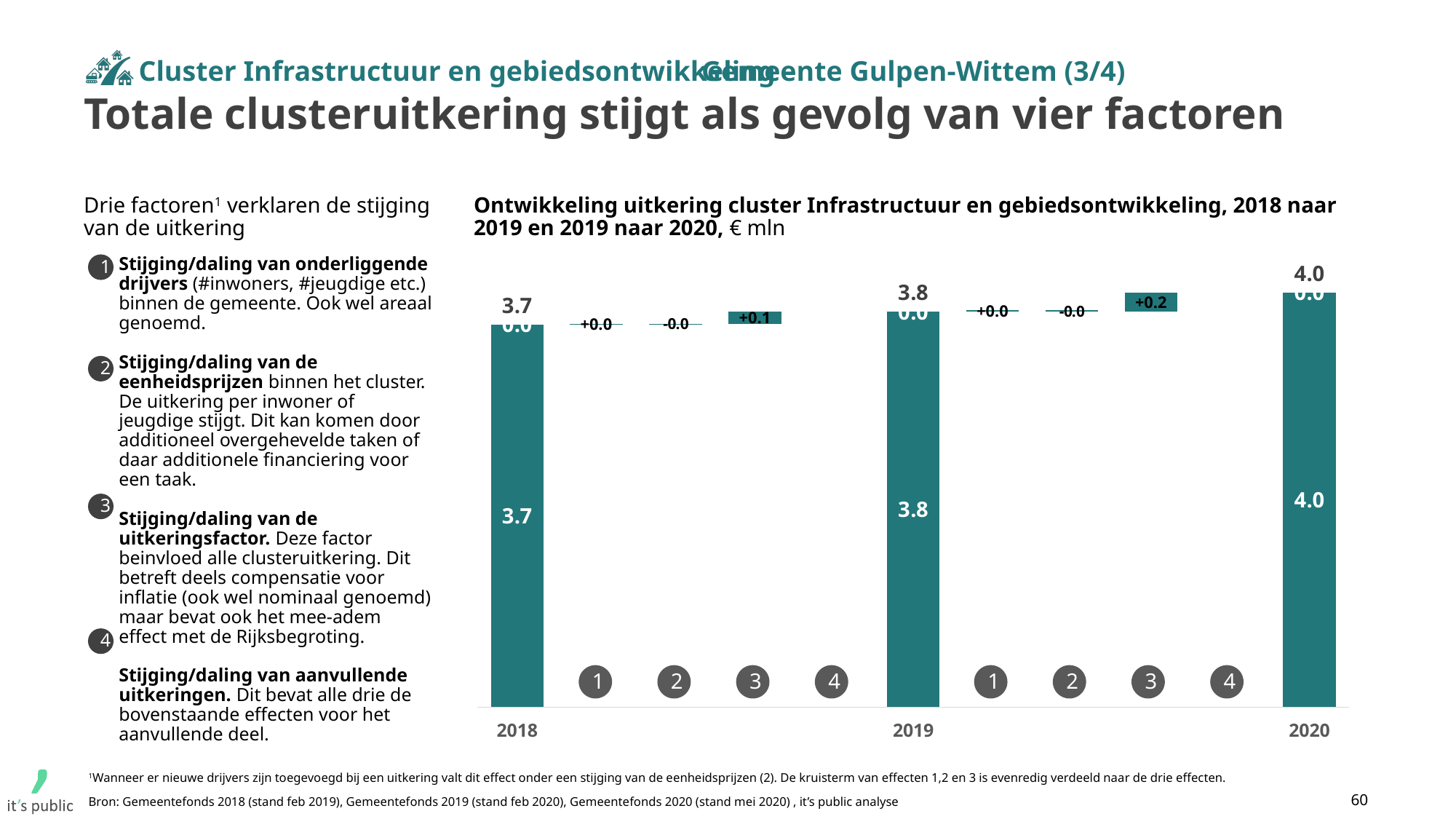
What is the value of factor 3 in the step from 2018 to 2019? +0.1 What is the difference between the 2020 total and the 2018 total? 0.3 How many year totals are shown on the x axis? 3 What is the total cluster payout shown for 2019? 3.8 Is the total for 2019 larger or smaller than the total for 2020? smaller What is the total cluster payout shown for 2020? 4.0 What is the value of factor 1 in the step from 2019 to 2020? +0.0 What is the total cluster payout shown for 2018? 3.7 Which year has the lowest total cluster payout? 2018 What is the value of factor 3 in the step from 2019 to 2020? +0.2 In what unit are the values in the chart expressed? € mln Which year has the highest total cluster payout? 2020